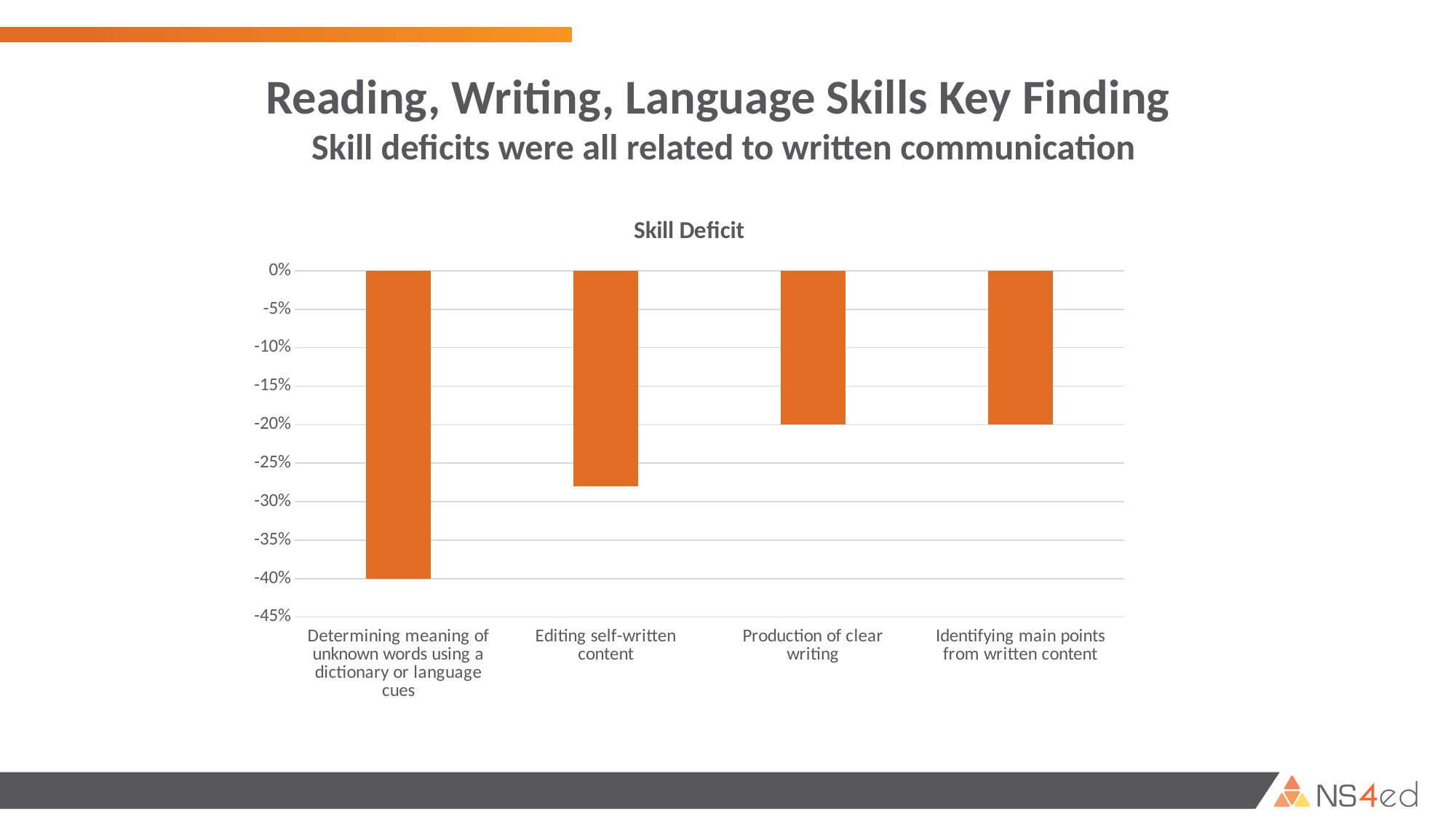
What is the lowest value shown on the vertical axis? -45% What kind of chart is shown on the slide? bar chart Do the values rise or fall from left to right across the categories? rise How many categories are shown in the chart? 4 What is the difference between the values for Determining meaning of unknown words using a dictionary or language cues and Production of clear writing? 20 percentage points What is the title of the chart? Skill Deficit Which category has the largest skill deficit (the lowest value)? Determining meaning of unknown words using a dictionary or language cues Which has the larger deficit: Editing self-written content or Production of clear writing? Editing self-written content Is the value for Editing self-written content greater or less than -25%? less What is the value for Production of clear writing? -20% What is the value for Identifying main points from written content? -20% What is the value for Determining meaning of unknown words using a dictionary or language cues? -40%